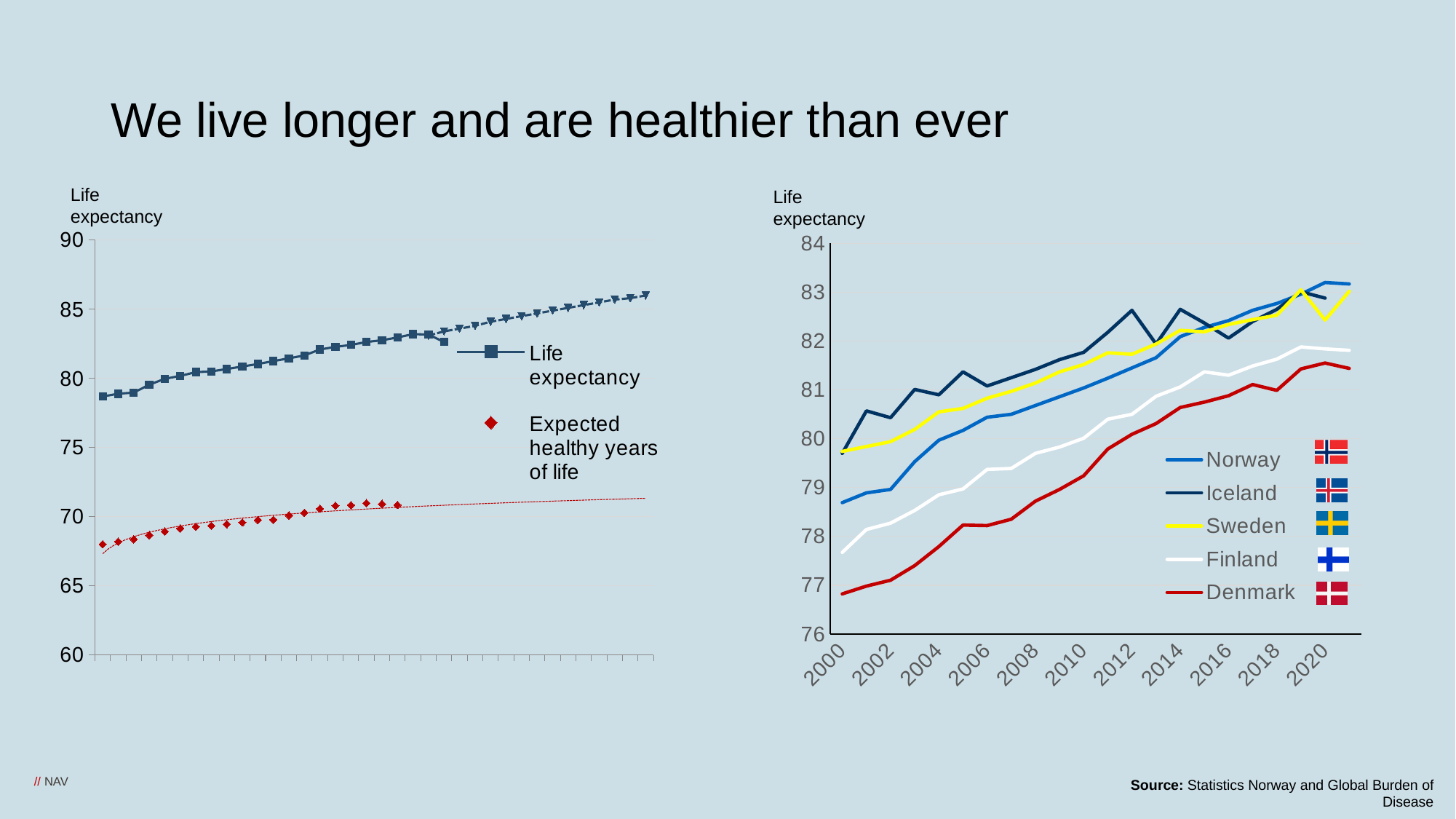
In the right-hand chart, does the life expectancy for Denmark rise or fall from 2000 to 2020? rise In the right-hand chart, is the value for Finland in 2000 greater or less than 78? less In the left-hand chart, which series has the higher values: Life expectancy or Expected healthy years of life? Life expectancy What kind of chart is the right-hand chart showing Norway, Iceland, Sweden, Finland and Denmark? line chart How many series does the legend of the left-hand chart list? 2 In the right-hand chart, is the value for Norway in 2020 greater or less than 82? greater How many series does the legend of the right-hand chart list? 5 In the right-hand chart, which is larger in 2010: the value for Norway or the value for Denmark? Norway In the right-hand chart, which country has the lowest life expectancy across the whole period shown? Denmark In the right-hand chart, is the value for Denmark in 2000 greater or less than 77? less In the right-hand chart, which country has the lowest life expectancy in 2000? Denmark